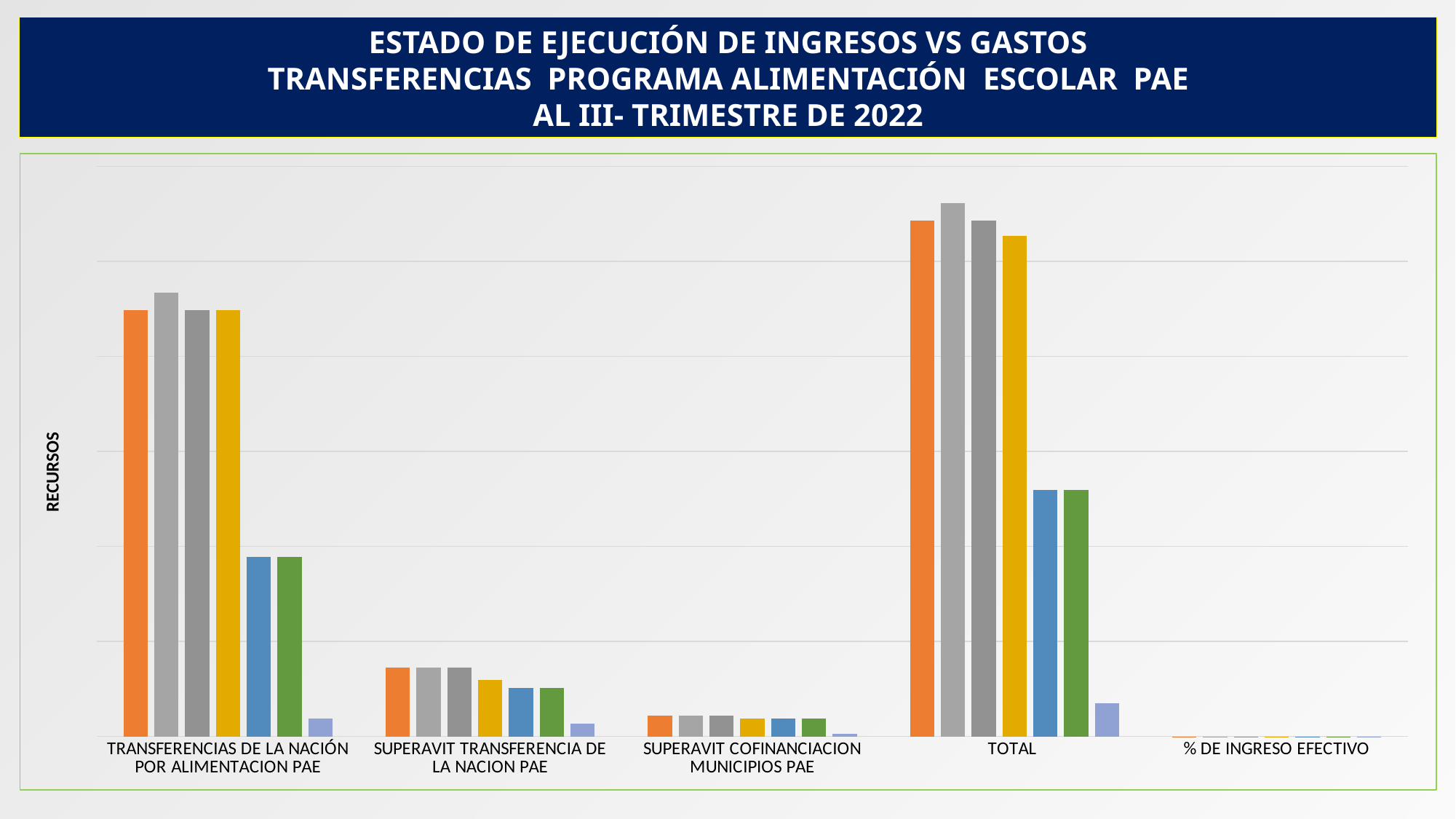
Which category has the smallest bars in the chart? % DE INGRESO EFECTIVO Which category has larger bars: SUPERAVIT TRANSFERENCIA DE LA NACION PAE or SUPERAVIT COFINANCIACION MUNICIPIOS PAE? SUPERAVIT TRANSFERENCIA DE LA NACION PAE What period does the chart title say the data covers? AL III- TRIMESTRE DE 2022 Which category has larger bars: TOTAL or TRANSFERENCIAS DE LA NACIÓN POR ALIMENTACION PAE? TOTAL How many categories are shown along the x axis of the chart? 5 Which category has larger bars: TRANSFERENCIAS DE LA NACIÓN POR ALIMENTACION PAE or SUPERAVIT TRANSFERENCIA DE LA NACION PAE? TRANSFERENCIAS DE LA NACIÓN POR ALIMENTACION PAE What kind of chart is shown on the slide? Bar chart What is the label on the vertical axis of the chart? RECURSOS Which category has the tallest bars in the chart? TOTAL How many bars are plotted for each category in the chart? 7